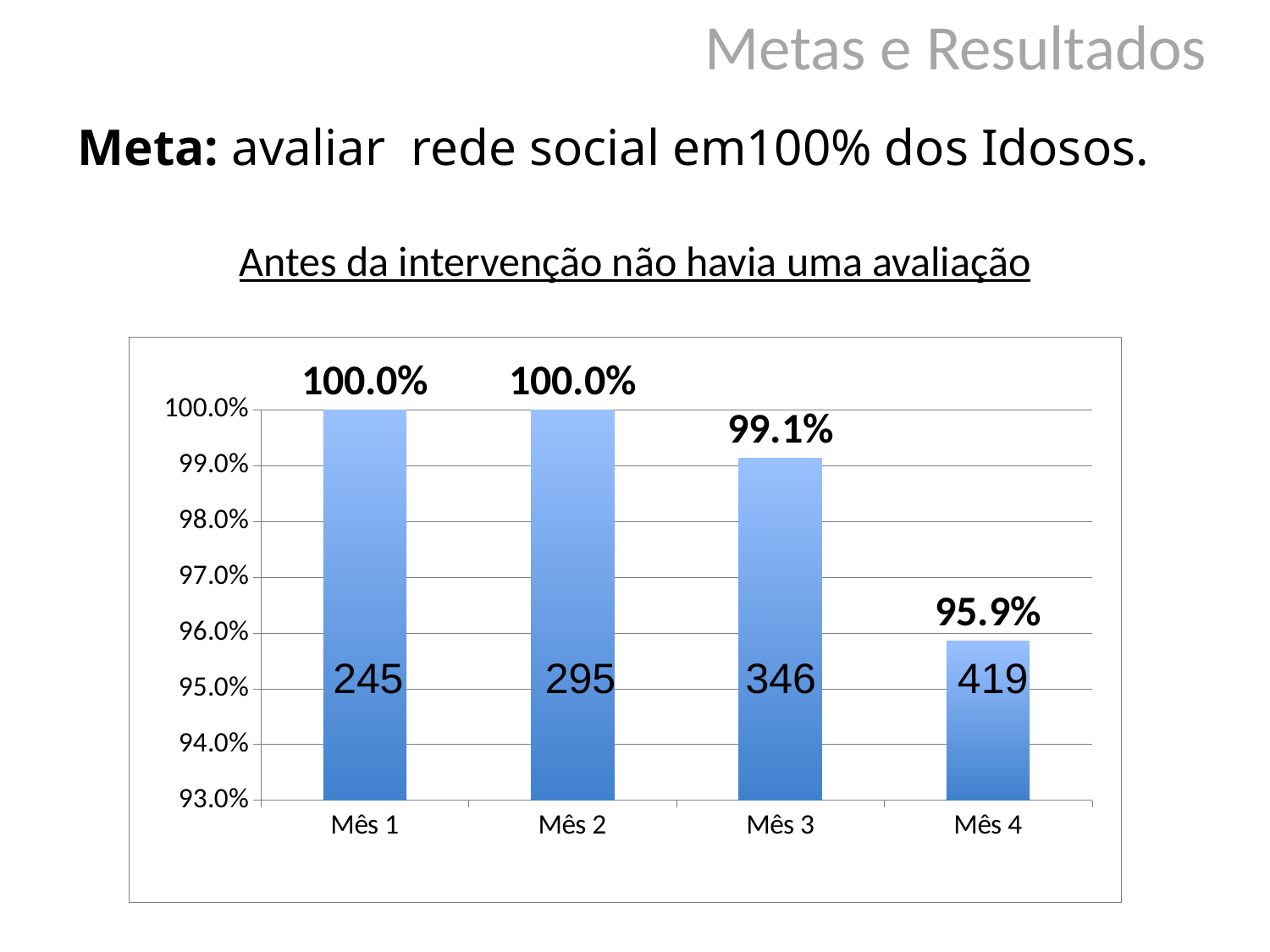
Which month has the lowest percentage value? Mês 4 What number is printed inside the bar for Mês 4? 419 What is the percentage value shown for Mês 4? 95.9% How many months are shown on the x axis? 4 What number is printed inside the bar for Mês 2? 295 What is the difference between the percentage values for Mês 1 and Mês 3? 0.9% Do the percentage values rise or fall from Mês 2 to Mês 4? fall What kind of chart is shown on the slide? bar chart Which has a higher percentage value, Mês 3 or Mês 4? Mês 3 What is the difference between the percentage values for Mês 3 and Mês 4? 3.2% What is the percentage value shown for Mês 3? 99.1% Is the value for Mês 4 greater or less than 97.0%? less